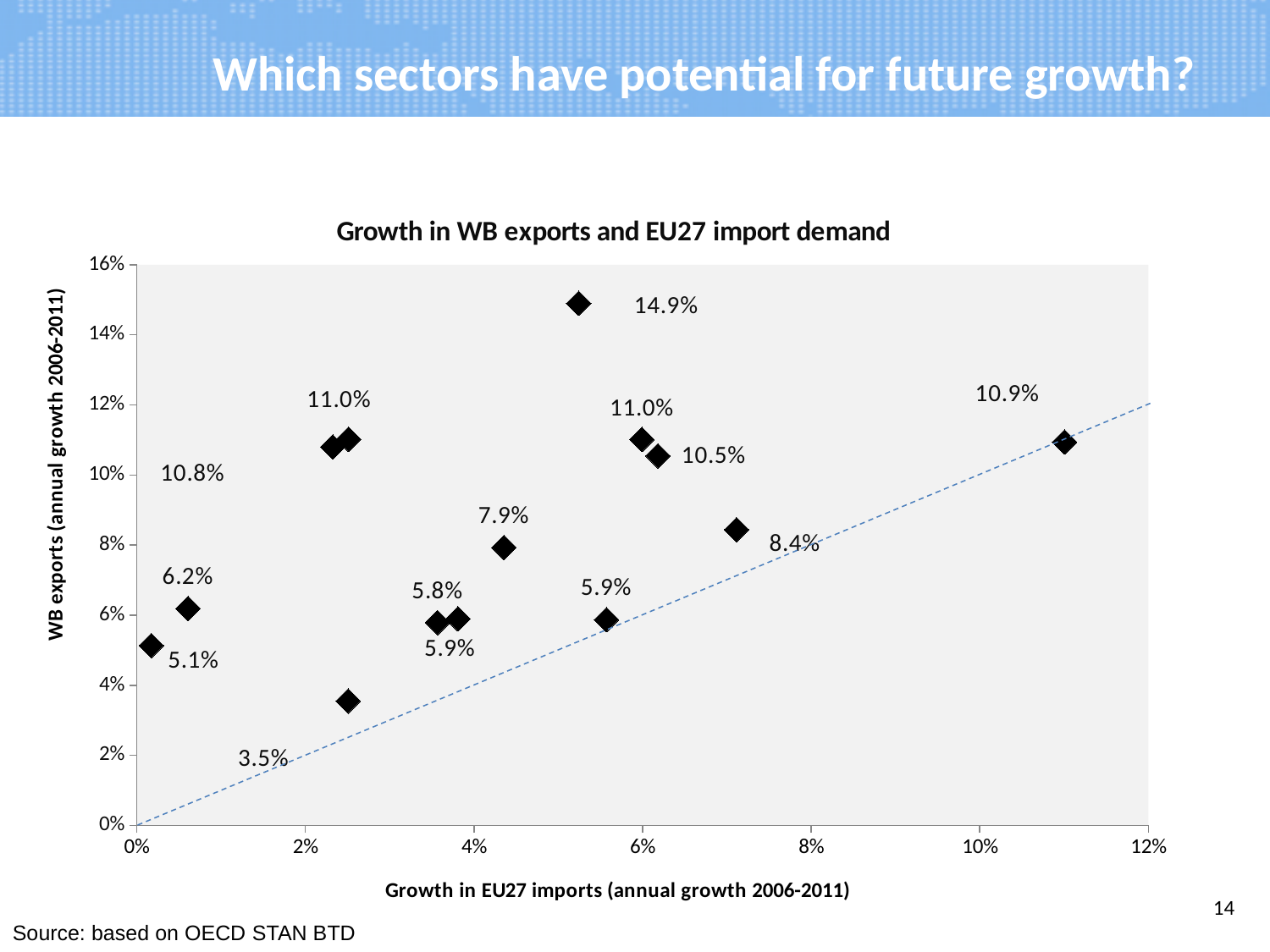
Is the EU27 import growth for the point labelled 5.1% greater or less than 2%? less What is the difference between the highest labelled WB export growth value (14.9%) and the lowest (3.5%)? 11.4% What kind of chart is shown on the slide? scatter chart What is the lowest WB export growth value labelled on the chart? 3.5% Is the EU27 import growth for the point labelled 14.9% greater or less than 4%? greater What is the title of the chart? Growth in WB exports and EU27 import demand What is the highest value shown on the vertical axis of the chart? 16% What is the label of the horizontal axis of the chart? Growth in EU27 imports (annual growth 2006-2011) Which is larger, the point labelled 8.4% or the point labelled 7.9%? 8.4% How many data points are plotted on the chart? 14 Is the EU27 import growth for the point labelled 10.9% greater or less than 10%? greater What is the highest WB export growth value labelled on the chart? 14.9%